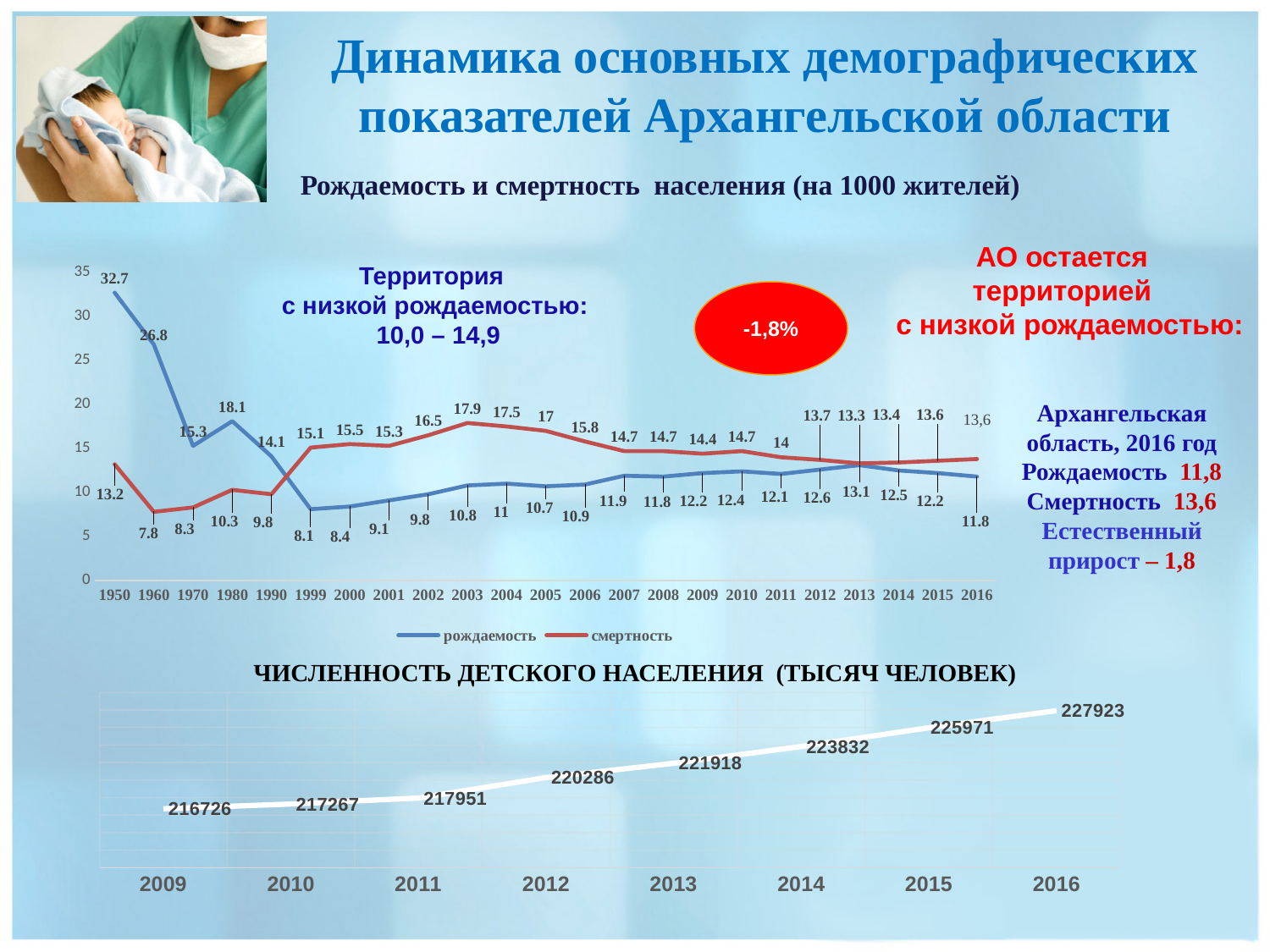
On the top chart (Рождаемость и смертность населения), in which year is смертность highest? 2003 On the bottom chart (ЧИСЛЕННОСТЬ ДЕТСКОГО НАСЕЛЕНИЯ), what is the difference between the 2016 and 2009 values? 11197 On the top chart (Рождаемость и смертность населения), what is the value of рождаемость in 1950? 32.7 On the top chart (Рождаемость и смертность населения), what kind of chart is it? line chart On the top chart (Рождаемость и смертность населения), which is larger in 1980: рождаемость or смертность? рождаемость On the top chart (Рождаемость и смертность населения), what is the value of смертность in 2003? 17.9 On the bottom chart (ЧИСЛЕННОСТЬ ДЕТСКОГО НАСЕЛЕНИЯ), what is the value for 2013? 221918 On the bottom chart (ЧИСЛЕННОСТЬ ДЕТСКОГО НАСЕЛЕНИЯ), how many years are plotted? 8 On the top chart (Рождаемость и смертность населения), in which year is рождаемость lowest? 1999 On the top chart (Рождаемость и смертность населения), what is the difference between смертность and рождаемость in 2016? 1.8 On the top chart (Рождаемость и смертность населения), how many series does the legend list? 2 On the bottom chart (ЧИСЛЕННОСТЬ ДЕТСКОГО НАСЕЛЕНИЯ), do the values rise or fall from 2009 to 2016? rise